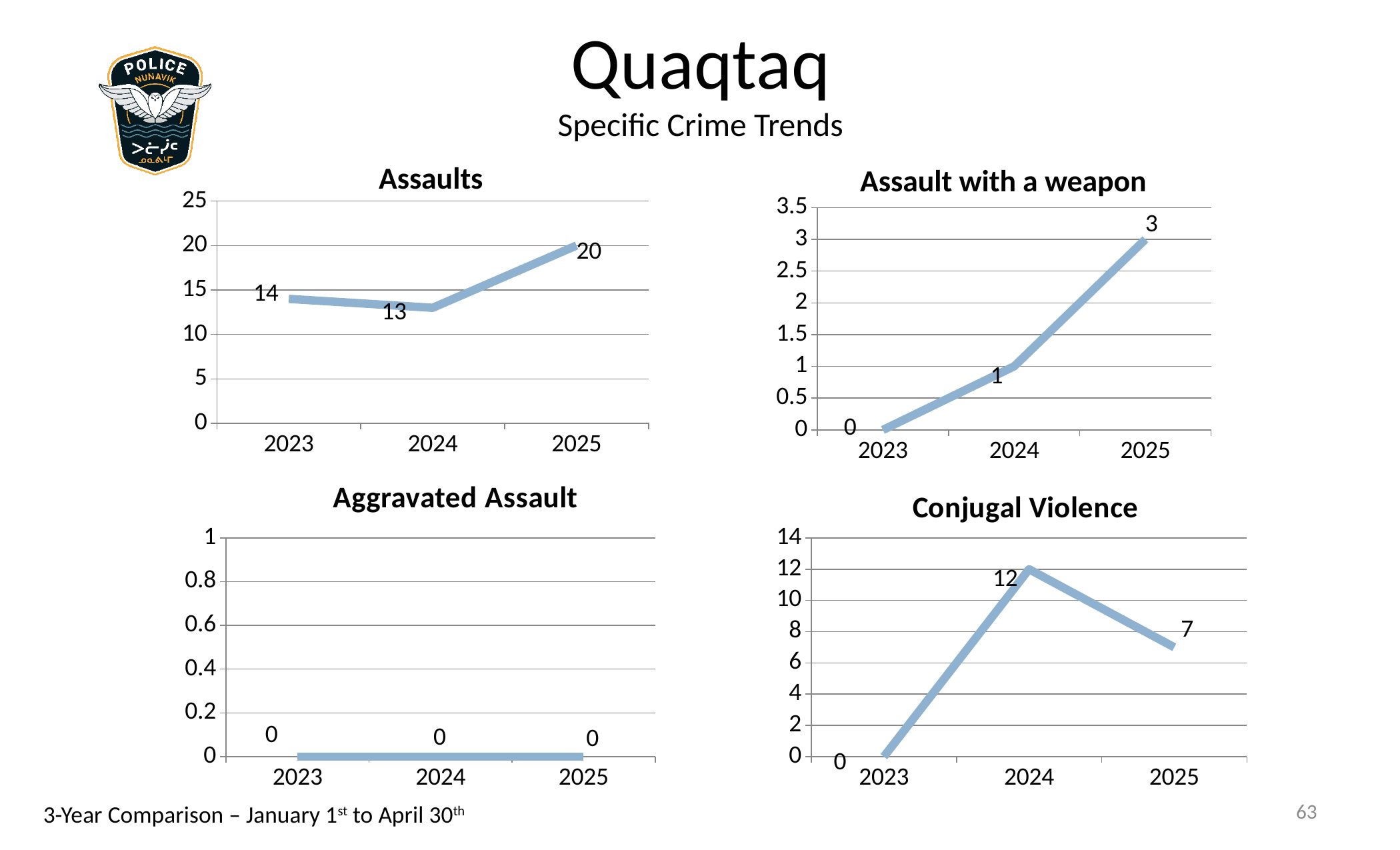
In the Assaults chart, which year has the lowest value? 2024 In the Conjugal Violence chart, what is the value for 2024? 12 In the Assaults chart, what is the difference between the 2025 and 2024 values? 7 In the Conjugal Violence chart, which is larger, the value for 2024 or the value for 2025? 2024 In the Assault with a weapon chart, what is the value for 2024? 1 In the Conjugal Violence chart, what is the difference between the 2024 and 2025 values? 5 In the Assault with a weapon chart, do the values rise or fall from 2023 to 2025? rise In the Aggravated Assault chart, what is the value for 2024? 0 What kind of chart is the Conjugal Violence chart? line chart In the Assault with a weapon chart, which year has the highest value? 2025 In the Assaults chart, what is the value for 2025? 20 How many data points are plotted in the Aggravated Assault chart? 3